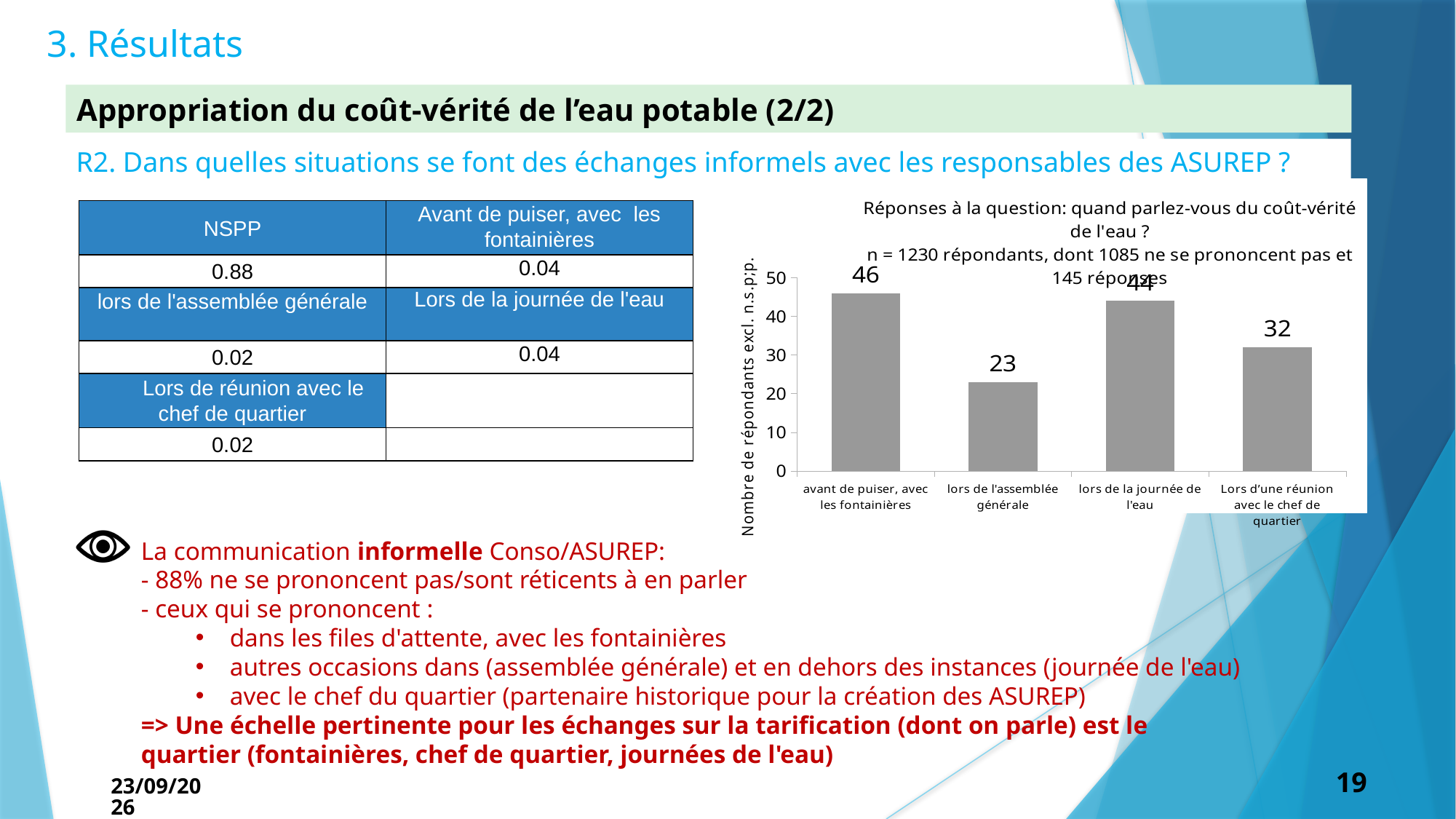
What kind of chart is shown on the slide? bar chart Which is larger: the value for "lors de la journée de l'eau" or the value for "Lors d'une réunion avec le chef de quartier"? lors de la journée de l'eau What is the value for "Lors d'une réunion avec le chef de quartier"? 32 Which category has the lowest value? lors de l'assemblée générale What is the value for "lors de l'assemblée générale"? 23 Which category has the highest value? avant de puiser, avec les fontainières How many categories are shown on the x axis of the chart? 4 What is the value for "avant de puiser, avec les fontainières"? 46 What is the value for "lors de la journée de l'eau"? 44 What is the label of the vertical axis of the chart? Nombre de répondants excl. n.s.p;p. What is the difference between the values for "avant de puiser, avec les fontainières" and "lors de l'assemblée générale"? 23 Is the value for "Lors d'une réunion avec le chef de quartier" greater or less than 40? less